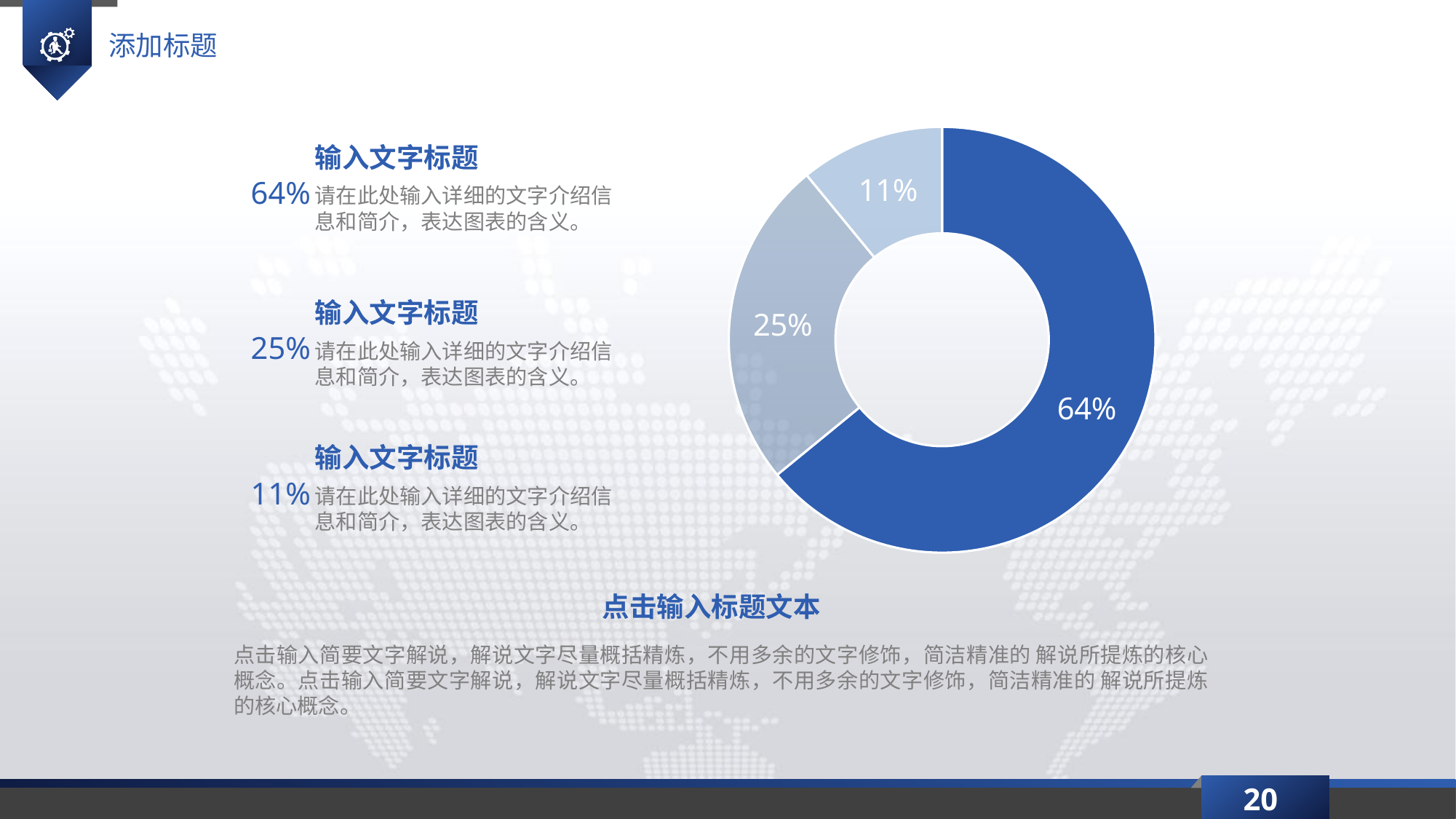
What is the difference between the largest slice (64%) and the smallest slice (11%)? 53% Which slice is larger, the dark blue one or the lightest blue one? the dark blue one What value is shown on the medium grey-blue slice on the left of the doughnut chart? 25% What value is shown on the dark blue slice of the doughnut chart? 64% What do the three slice values of the doughnut chart add up to? 100% What value is shown on the lightest blue slice of the doughnut chart? 11% What is the value of the smallest slice in the doughnut chart? 11% What kind of chart is shown on the slide? doughnut chart How many slices does the doughnut chart have? 3 What is the value of the largest slice in the doughnut chart? 64% What is the difference between the 25% slice and the 11% slice? 14% What share of the doughnut does the dark blue slice represent? 64%